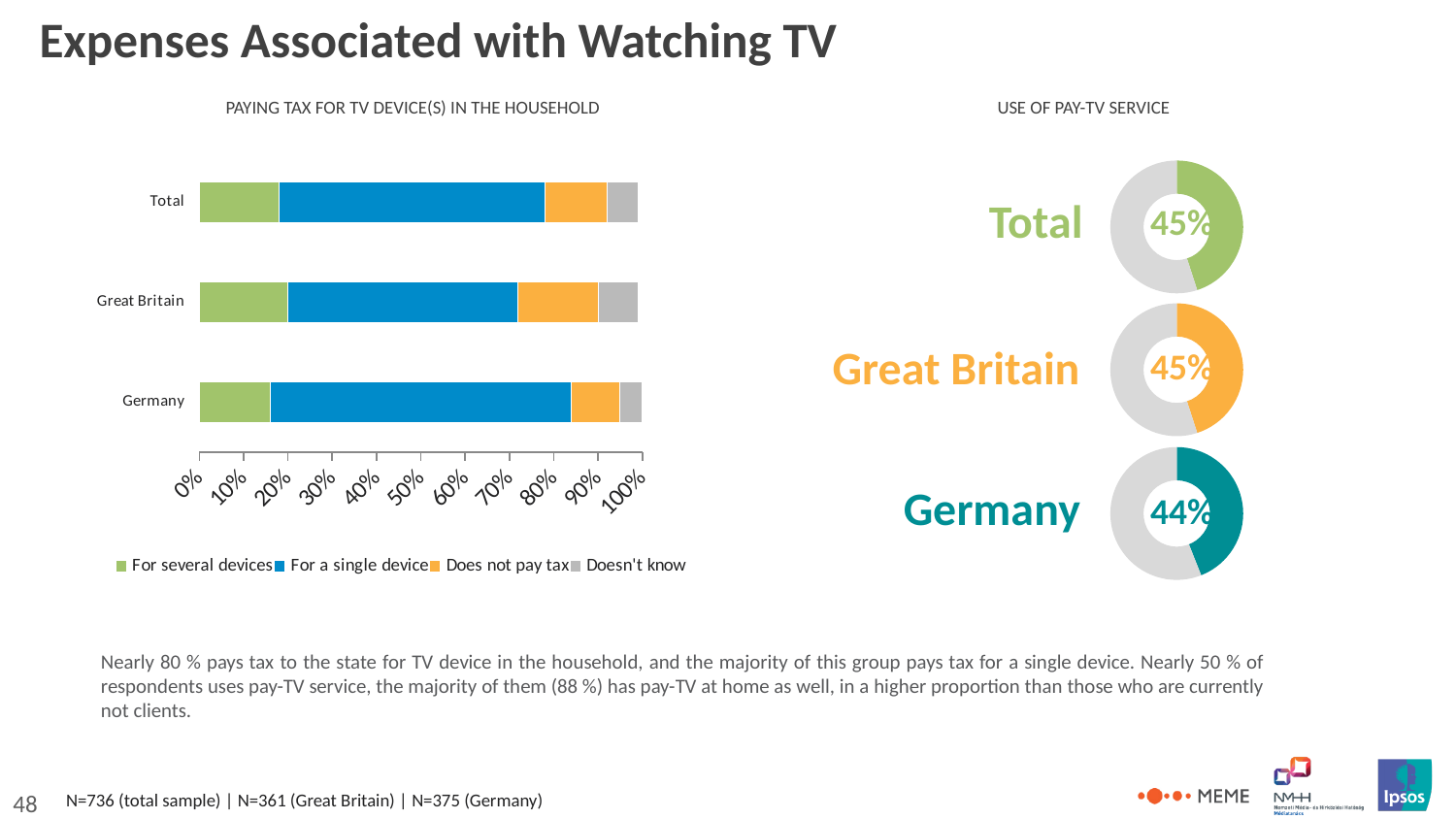
In the 'Paying tax for TV device(s) in the household' chart, which colour represents 'Does not pay tax'? Orange In the 'Use of pay-TV service' donut charts, what is the value shown for Germany? 44% In the 'Use of pay-TV service' donut charts, what is the difference between the Great Britain value and the Germany value? 1% What kind of chart is 'Paying tax for TV device(s) in the household'? Stacked bar chart In the 'Use of pay-TV service' donut charts, what is the value shown for Total? 45% How many donut charts are shown under 'Use of pay-TV service'? 3 In the 'Use of pay-TV service' donut charts, which group has the lowest share using pay-TV? Germany In the 'Use of pay-TV service' donut charts, what is the value shown for Great Britain? 45% In the 'Paying tax for TV device(s) in the household' chart, is the 'For several devices' segment for Total greater or less than 10%? greater How many series does the legend of the 'Paying tax for TV device(s) in the household' chart list? 4 In the 'Paying tax for TV device(s) in the household' chart, which has the larger 'For a single device' segment, Germany or Great Britain? Germany How many categories are plotted in the 'Paying tax for TV device(s) in the household' chart? 3